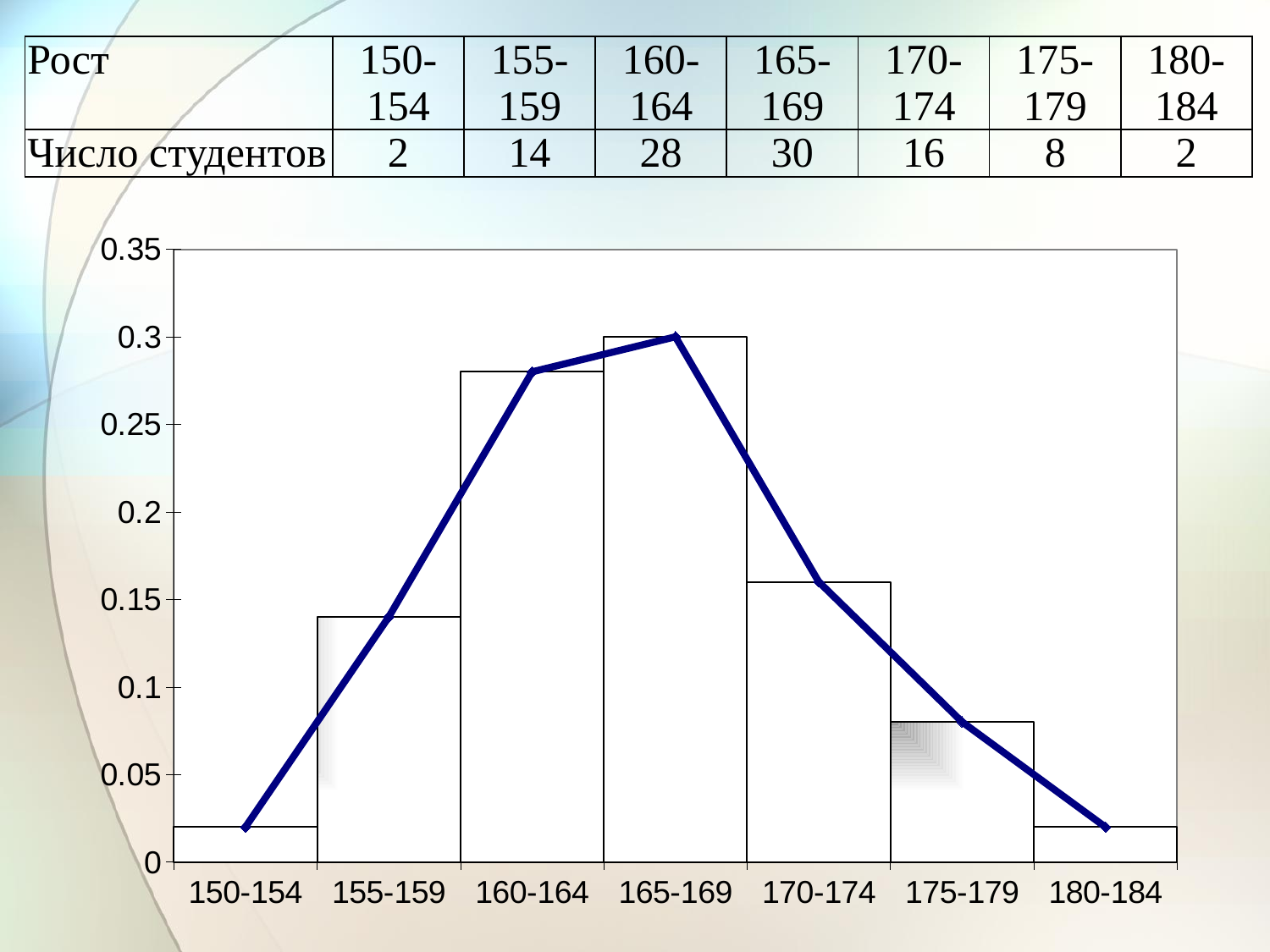
Is the value for 175-179 greater or less than 0.1? less Which height category has the highest bar in the chart? 165-169 How many height categories are shown on the x axis of the chart? 7 Is the value for 155-159 greater or less than 0.1? greater Which is larger in the chart, the value for 155-159 or the value for 175-179? 155-159 What is the value of the bar for 165-169 in the chart? 0.3 Is the value for 150-154 greater or less than 0.05? less What kind of chart is shown on the slide? bar chart with a line Which is larger in the chart, the value for 160-164 or the value for 170-174? 160-164 Do the values in the chart rise or fall from 165-169 to 180-184? fall